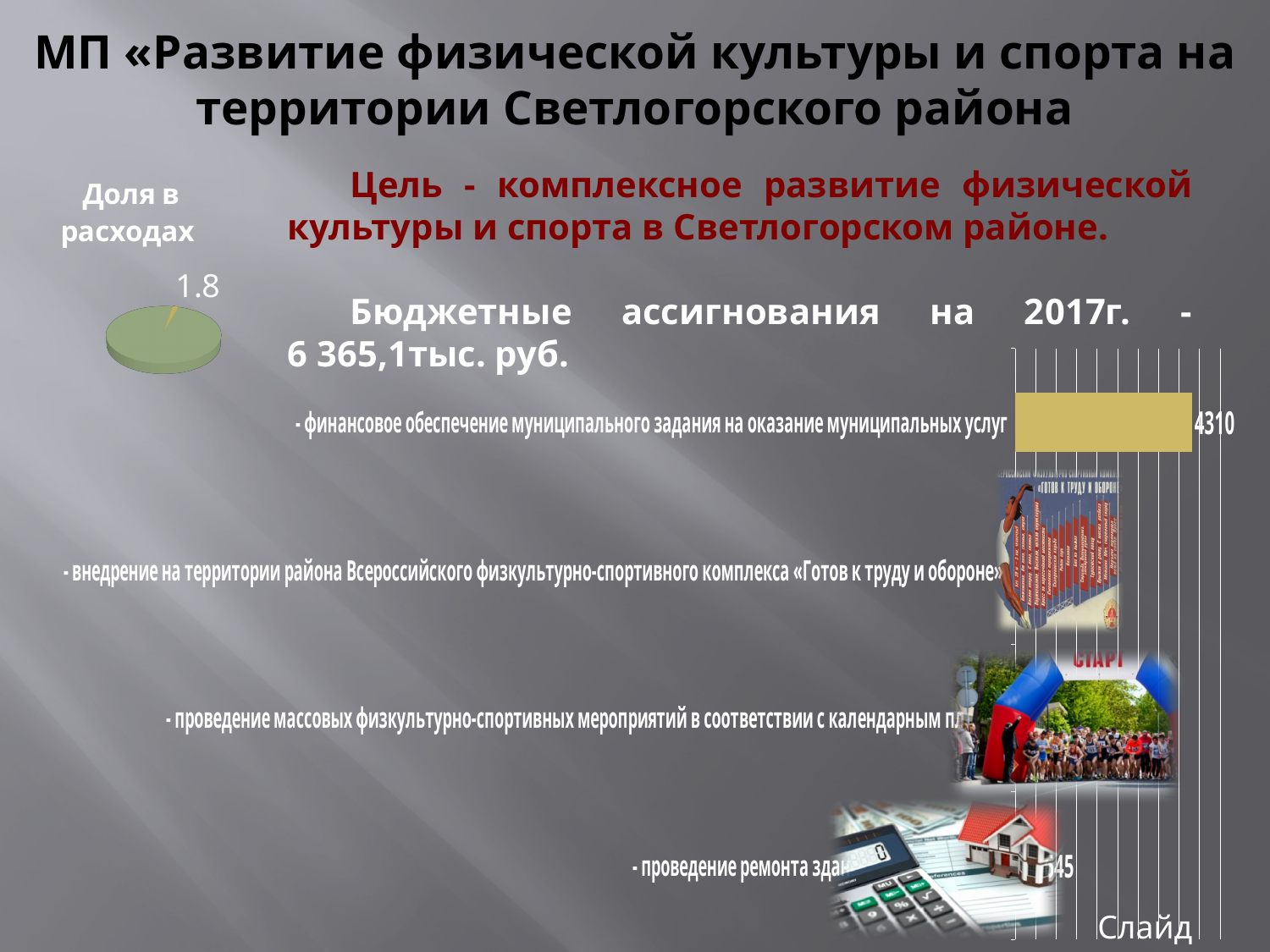
How many categories are listed in the bar chart on the right of the slide? 4 In the bar chart on the right of the slide, what is the value for "финансовое обеспечение муниципального задания на оказание муниципальных услуг"? 4310 What kind of chart is shown under the heading "Доля в расходах" on the left of the slide? pie chart In the bar chart on the right of the slide, which category has the highest value? финансовое обеспечение муниципального задания на оказание муниципальных услуг What is the title shown above the pie chart on the left of the slide? Доля в расходах What kind of chart is shown on the right side of the slide listing the programme activities? bar chart Are the bars in the bar chart on the right of the slide horizontal or vertical? horizontal What value is labelled on the pie chart "Доля в расходах"? 1.8